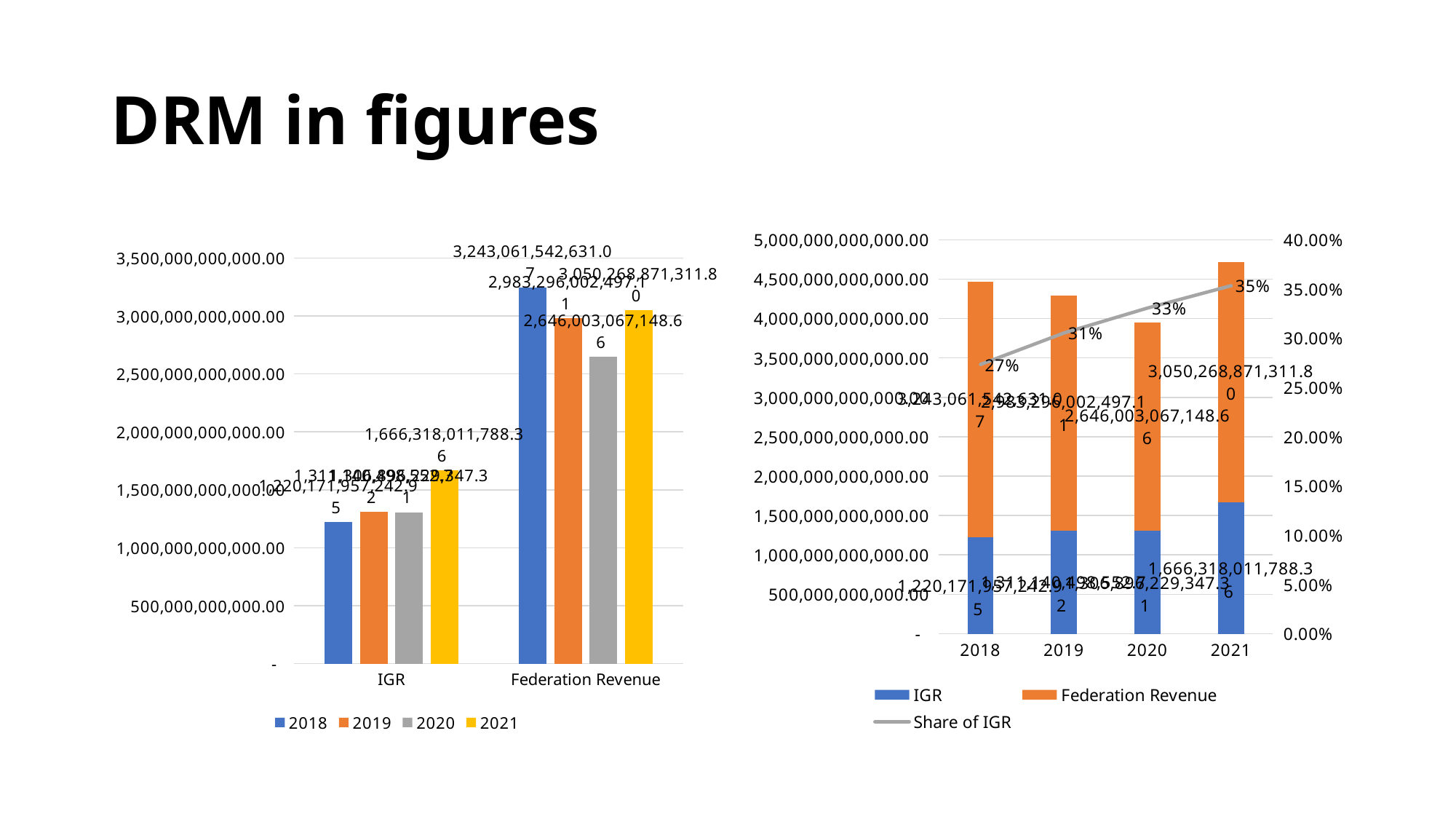
In the right chart, what is the Share of IGR in 2018? 27% In the right chart, does the Share of IGR line rise or fall from 2018 to 2021? rise In the right chart, what is the Share of IGR in 2020? 33% In the right chart, what is the Share of IGR in 2021? 35% How many series does the legend of the right chart list? 3 How many series does the legend of the left chart list? 4 How many years are shown on the x axis of the right chart? 4 In the left chart, which year has the highest Federation Revenue? 2018 In the left chart, which year has the lowest Federation Revenue? 2020 What kind of chart is the left chart? bar chart In the left chart, is the IGR value for 2021 greater or less than 1,500,000,000,000.00? greater In the right chart, by how many percentage points did the Share of IGR change between 2018 and 2021? 8 percentage points